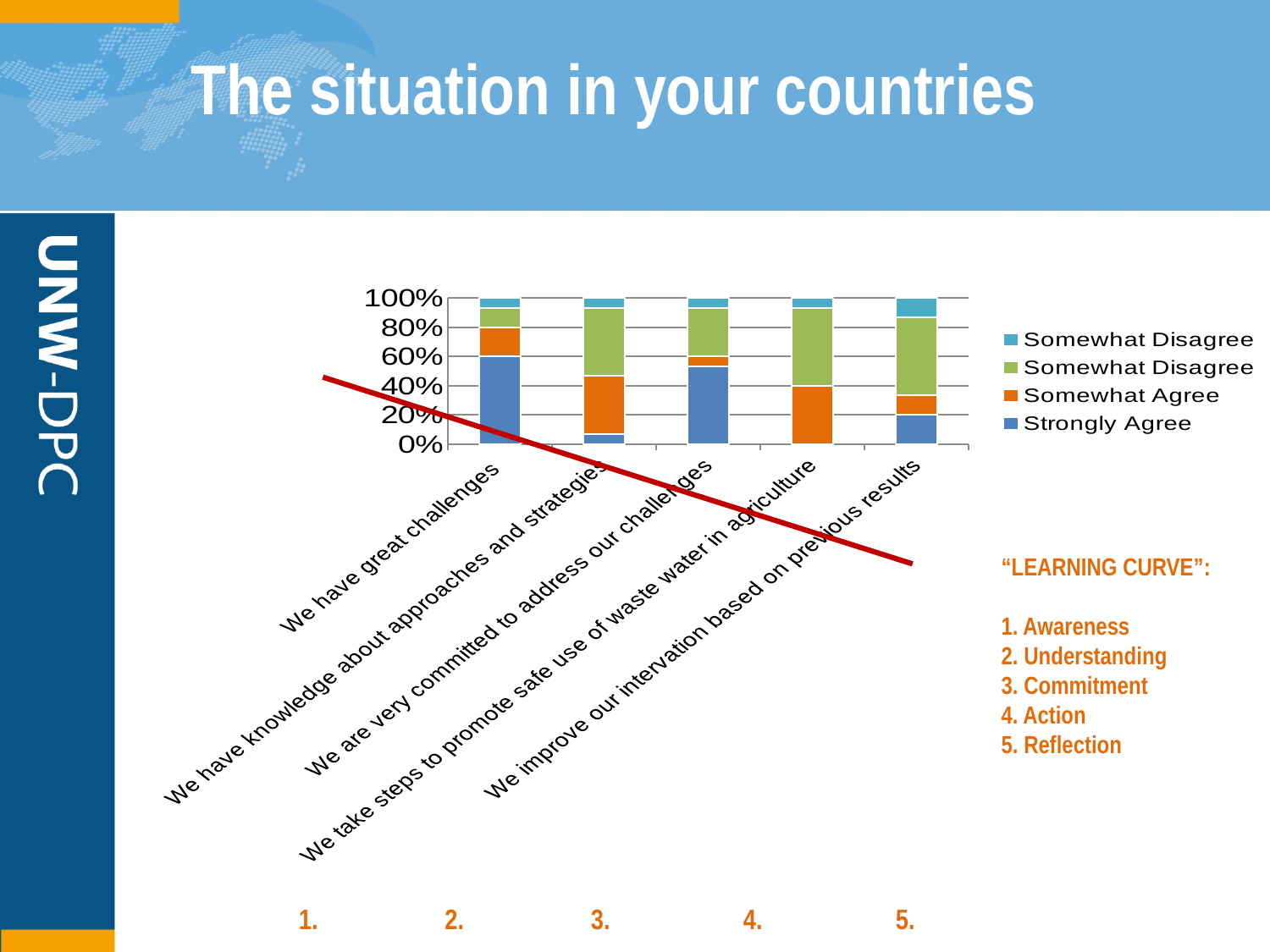
Is the Strongly Agree value for "We have knowledge about approaches and strategies" greater or less than 20%? less Which statement has the lowest Strongly Agree share? We take steps to promote safe use of waste water in agriculture Is the Strongly Agree value for "We have great challenges" greater or less than 40%? greater Which statement has the highest Strongly Agree share? We have great challenges What is the title of the slide containing the chart? The situation in your countries How many categories (statements) are plotted along the x axis of the chart? 5 Which has the larger Somewhat Agree share: "We have knowledge about approaches and strategies" or "We are very committed to address our challenges"? We have knowledge about approaches and strategies Is the Strongly Agree value for "We improve our intervation based on previous results" greater or less than 40%? less What kind of chart is shown on the slide? Stacked bar chart Which has the larger Strongly Agree share: "We have great challenges" or "We have knowledge about approaches and strategies"? We have great challenges How many series does the chart's legend list? 4